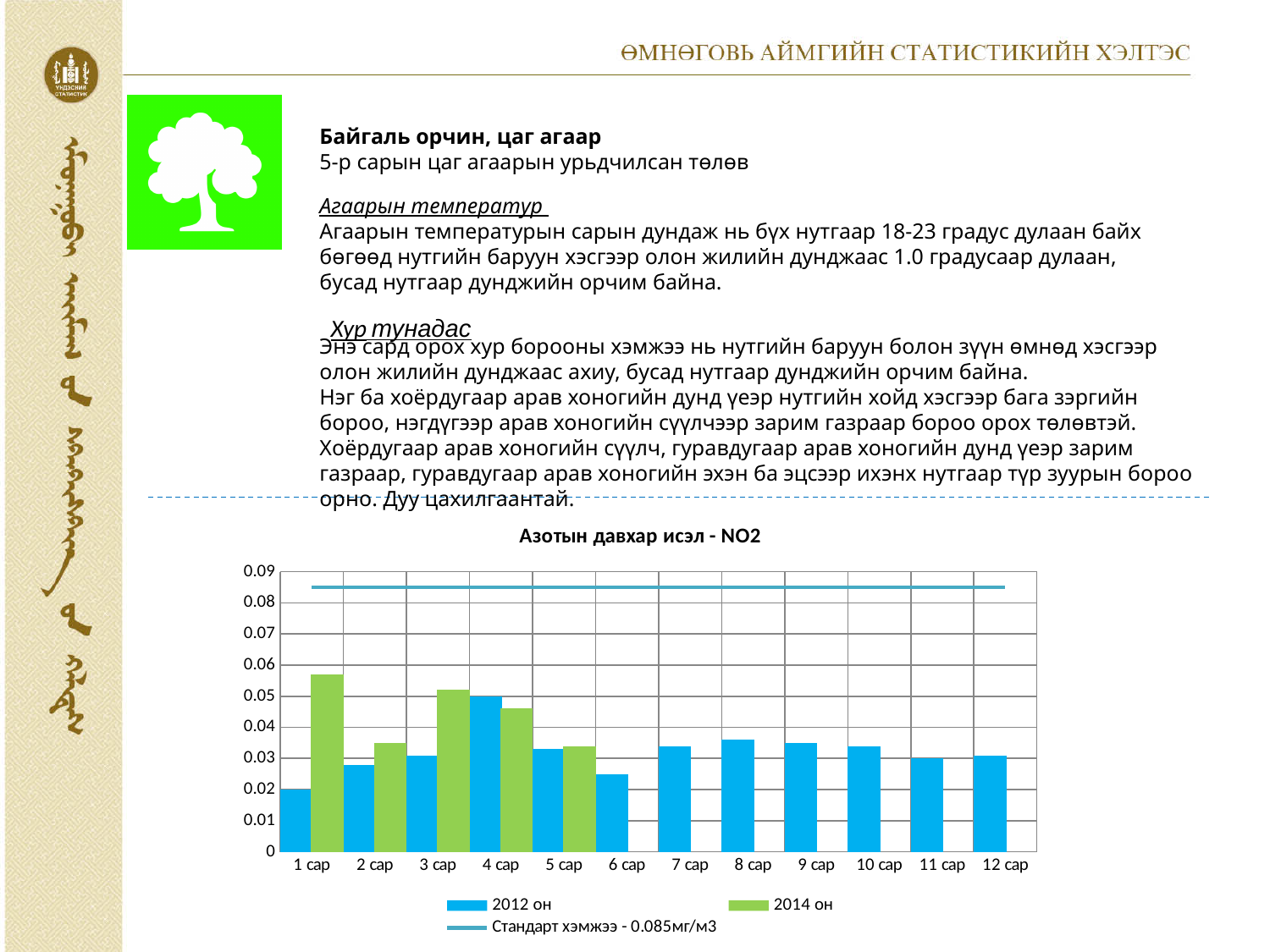
What is the title of the chart? Азотын давхар исэл - NO2 In 3 сар, which series has the larger value, 2012 он or 2014 он? 2014 он In which month is the 2012 он value highest? 4 сар In 1 сар, which series has the larger value, 2012 он or 2014 он? 2014 он In which month is the 2012 он value lowest? 1 сар What kind of chart is shown on the slide? bar chart In which month is the 2014 он value highest? 1 сар Is the 2014 он value for 1 сар greater or less than 0.05? greater How many series does the legend of the NO2 chart list? 3 How many month categories are shown on the x axis of the NO2 chart? 12 What standard level is stated in the legend for the horizontal line? 0.085мг/м3 Is the 2012 он value for 6 сар greater or less than 0.03? less